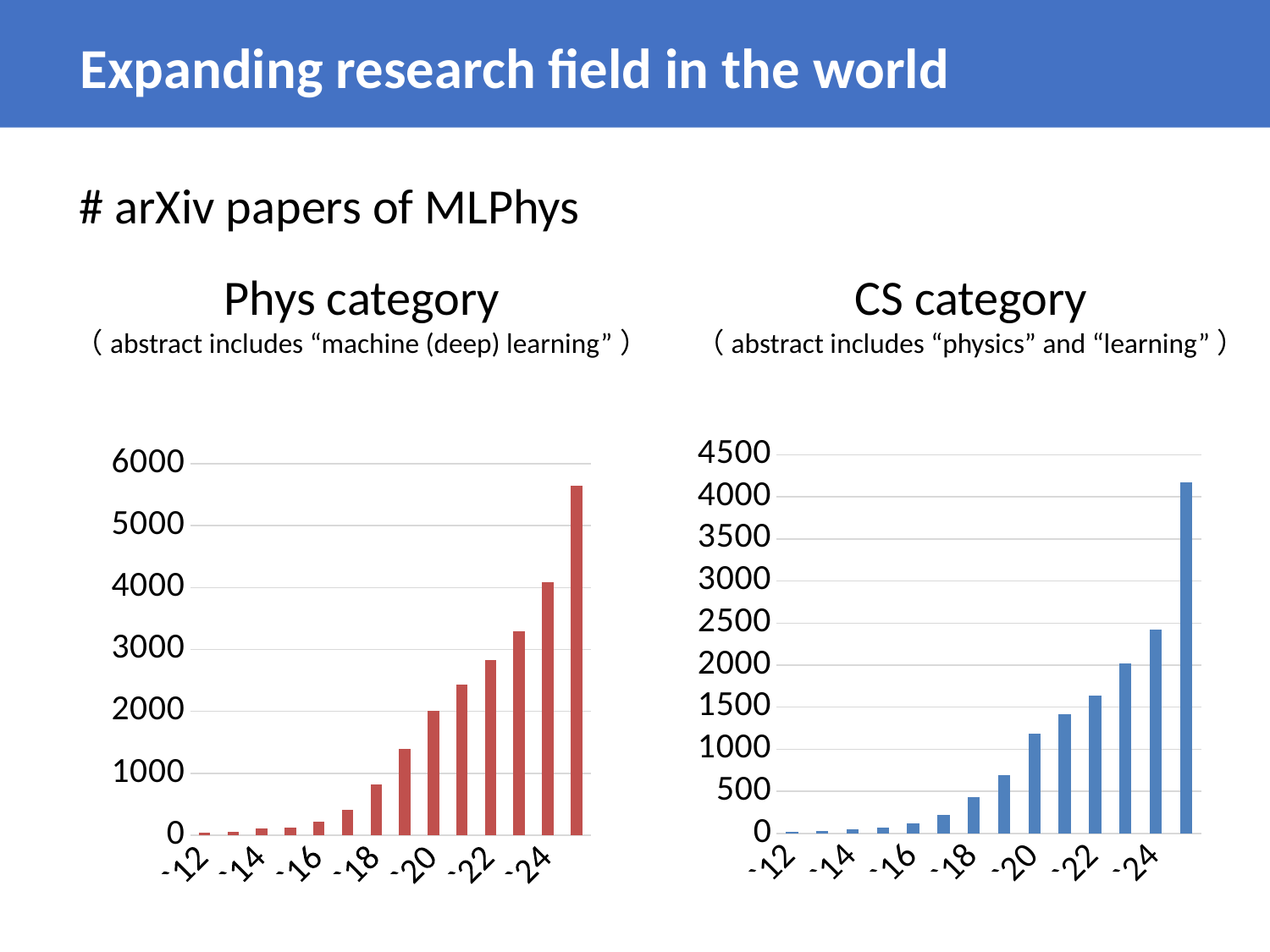
In the Phys category chart, do the values rise or fall from left to right along the x axis? rise In the Phys category chart, is the value of the tallest (rightmost) bar greater or less than 5000? greater What kind of chart is the Phys category chart? bar chart In the Phys category chart, is the value for -18 greater or less than 1000? less In the CS category chart, do the values rise or fall from left to right along the x axis? rise In the CS category chart, is the value for -24 greater or less than 2000? greater What kind of chart is the CS category chart? bar chart What colour are the bars in the CS category chart? blue How many bars are plotted in the Phys category chart? 14